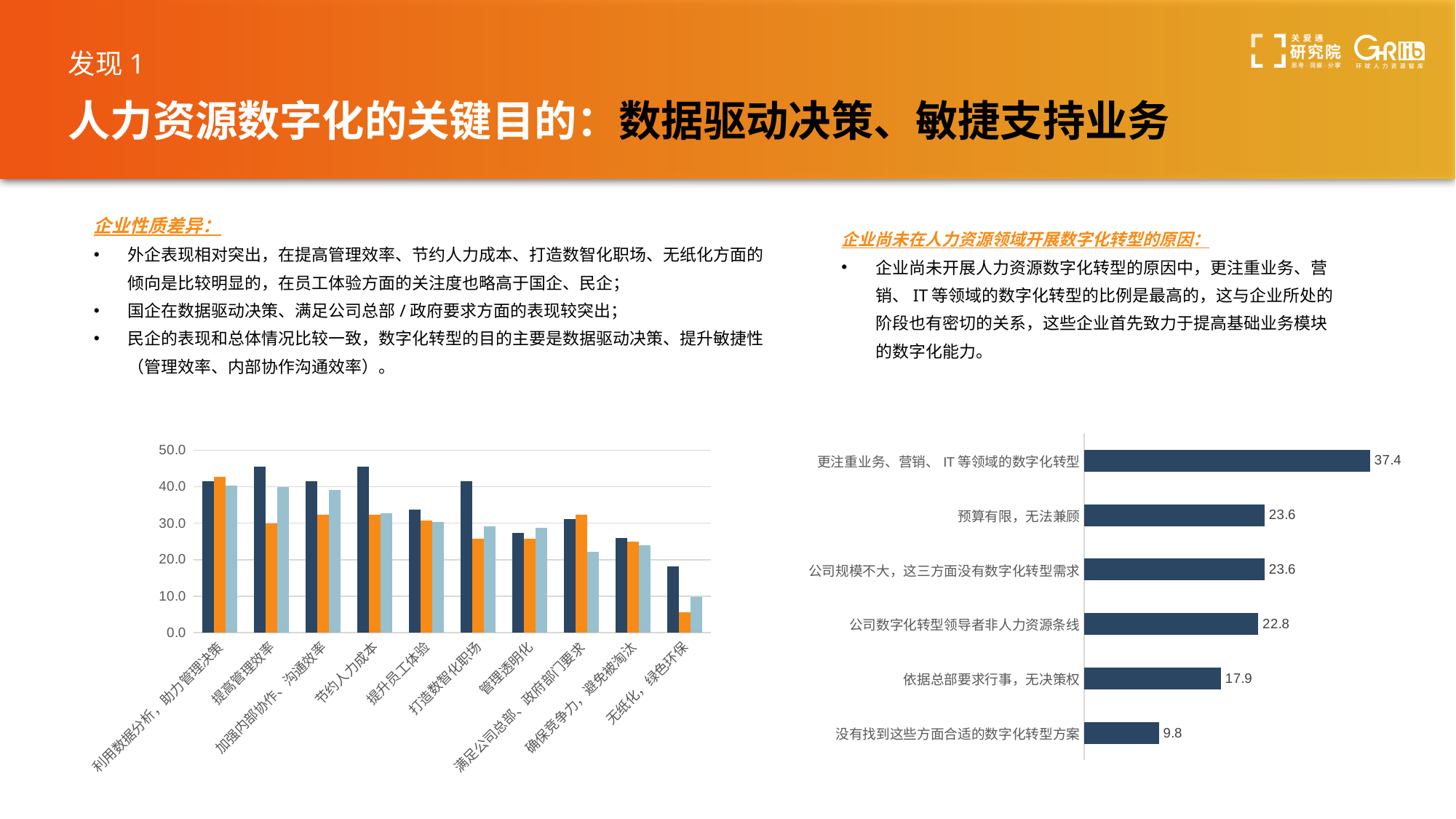
What kind of chart is the chart on the right side of the slide? Bar chart In the right-hand horizontal bar chart, what is the value for 依据总部要求行事，无决策权? 17.9 In the left-hand chart, is the dark blue bar for 无纸化、绿色环保 greater or less than 20.0? less In the right-hand horizontal bar chart, which category has the lowest value? 没有找到这些方面合适的数字化转型方案 In the right-hand horizontal bar chart, which category has the highest value? 更注重业务、营销、IT等领域的数字化转型 How many differently coloured bars are shown for each category in the left-hand chart? 3 How many categories are shown on the x axis of the left-hand chart? 10 How many categories does the right-hand horizontal bar chart show? 6 In the left-hand chart, is the dark blue bar for 节约人力成本 greater or less than 40.0? greater In the right-hand horizontal bar chart, what is the value for 更注重业务、营销、IT等领域的数字化转型? 37.4 In the right-hand horizontal bar chart, what is the difference between the values for 更注重业务、营销、IT等领域的数字化转型 and 预算有限，无法兼顾? 13.8 In the right-hand horizontal bar chart, which is larger: the value for 公司数字化转型领导者非人力资源条线 or the value for 依据总部要求行事，无决策权? 公司数字化转型领导者非人力资源条线